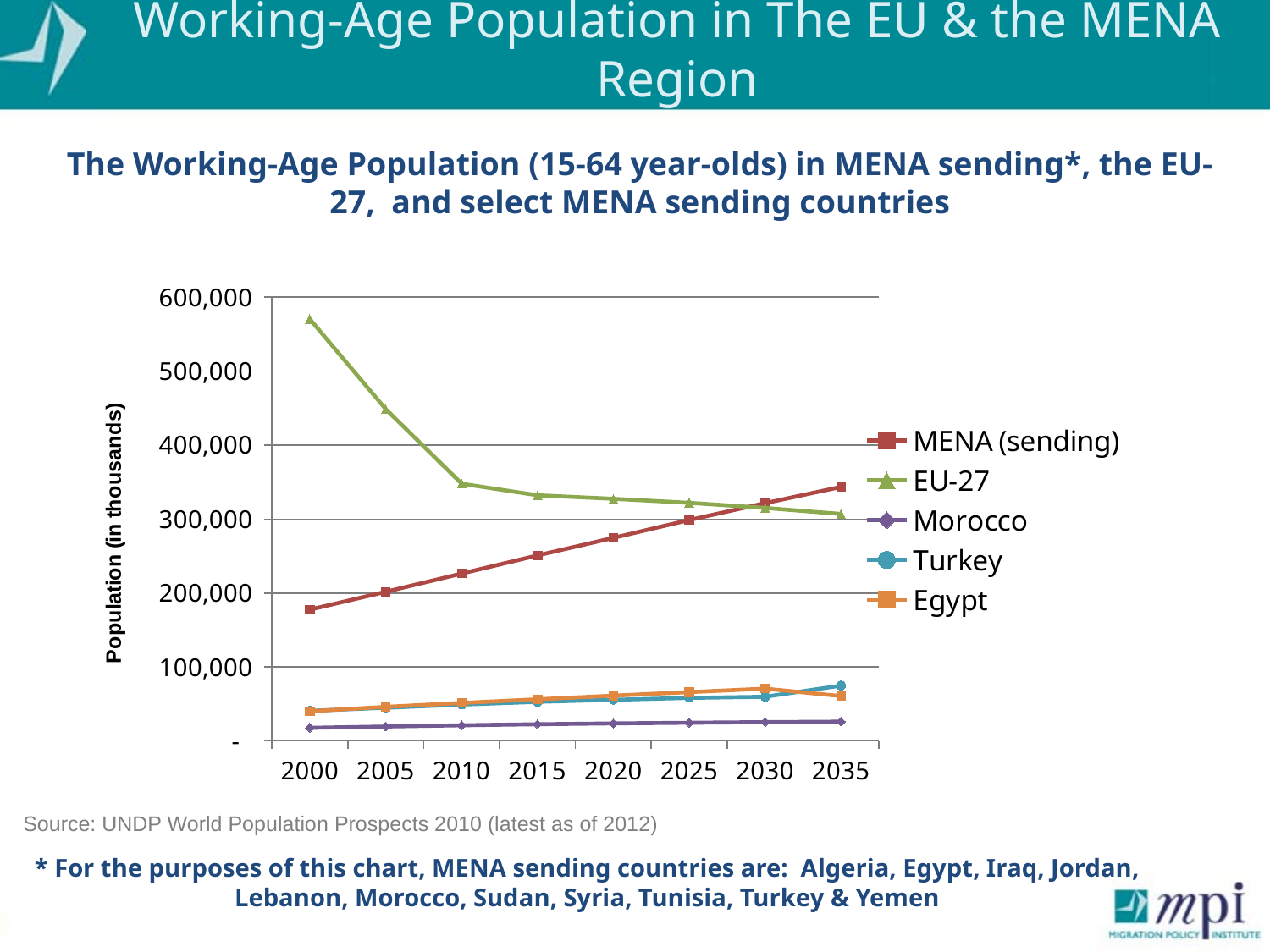
Is the value for EU-27 in 2010 greater or less than 400,000? less Does the EU-27 series rise or fall from 2000 to 2035? fall Is the value for MENA (sending) in 2035 greater or less than 300,000? greater Which series has the lowest value in 2035? Morocco Which series has the highest value in 2000? EU-27 How many years are plotted along the x axis? 8 In 2035, which is larger: MENA (sending) or EU-27? MENA (sending) What is the label of the y axis? Population (in thousands) Is the value for EU-27 in 2000 greater or less than 500,000? greater How many series does the legend list? 5 What kind of chart is shown on the slide? line chart